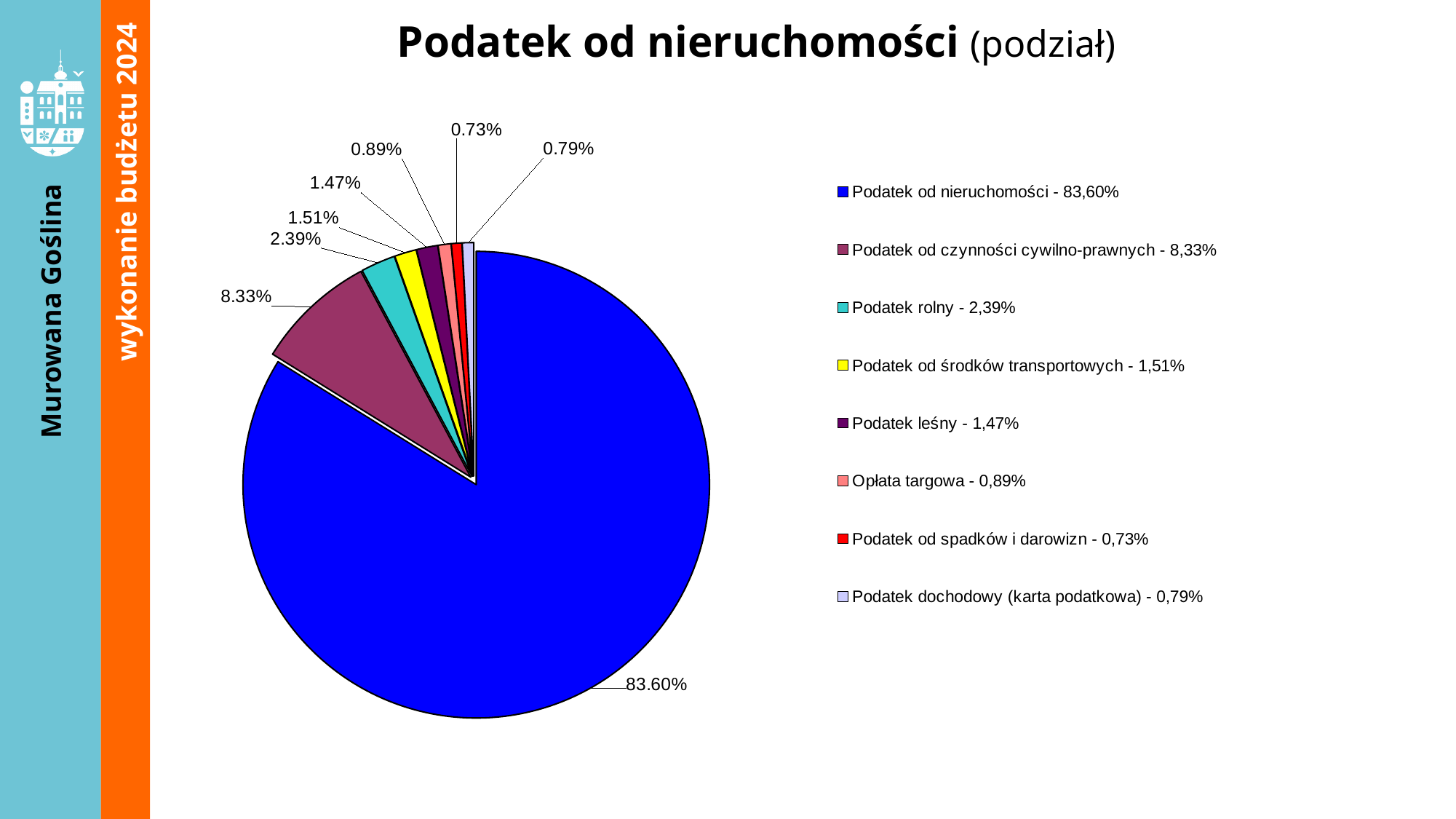
Which category has the smallest slice of the pie? Podatek od spadków i darowizn What is the value shown for Opłata targowa? 0.89% What kind of chart is shown on the slide? pie chart How many slices does the pie chart have? 8 What colour is the slice for Podatek od nieruchomości? blue What is the value shown for Podatek od środków transportowych? 1.51% What share of the pie does Podatek od nieruchomości have? 83.60% What is the value shown for Podatek rolny? 2.39% Which category has the largest slice of the pie? Podatek od nieruchomości What is the difference between the shares of Podatek od czynności cywilno-prawnych and Podatek rolny? 5.94% What share of the pie does Podatek od czynności cywilno-prawnych have? 8.33% Which is larger, the share for Podatek leśny or the share for Podatek od środków transportowych? Podatek od środków transportowych